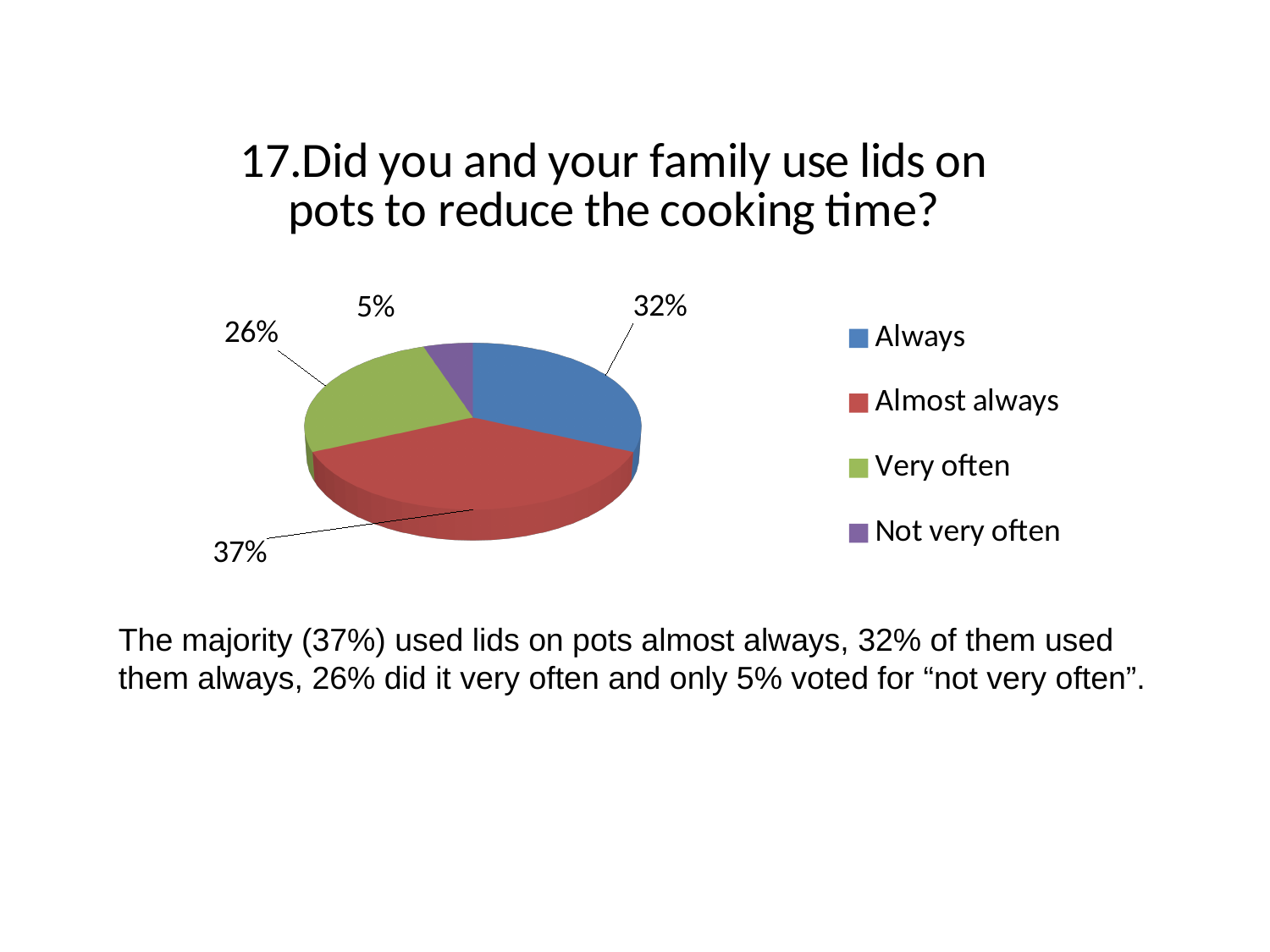
What percentage of respondents answered "Not very often"? 5% What is the difference in percentage points between "Almost always" and "Always"? 5 What colour represents "Very often" in the pie chart? green What percentage of respondents answered "Always"? 32% What percentage of respondents answered "Almost always"? 37% What is the combined share of "Always" and "Almost always"? 69% Which is larger, the share for "Very often" or the share for "Always"? Always What percentage of respondents answered "Very often"? 26% How many categories does the pie chart show? 4 What kind of chart is shown on the slide? pie chart Which response category has the largest share of the pie? Almost always Which response category has the smallest share of the pie? Not very often